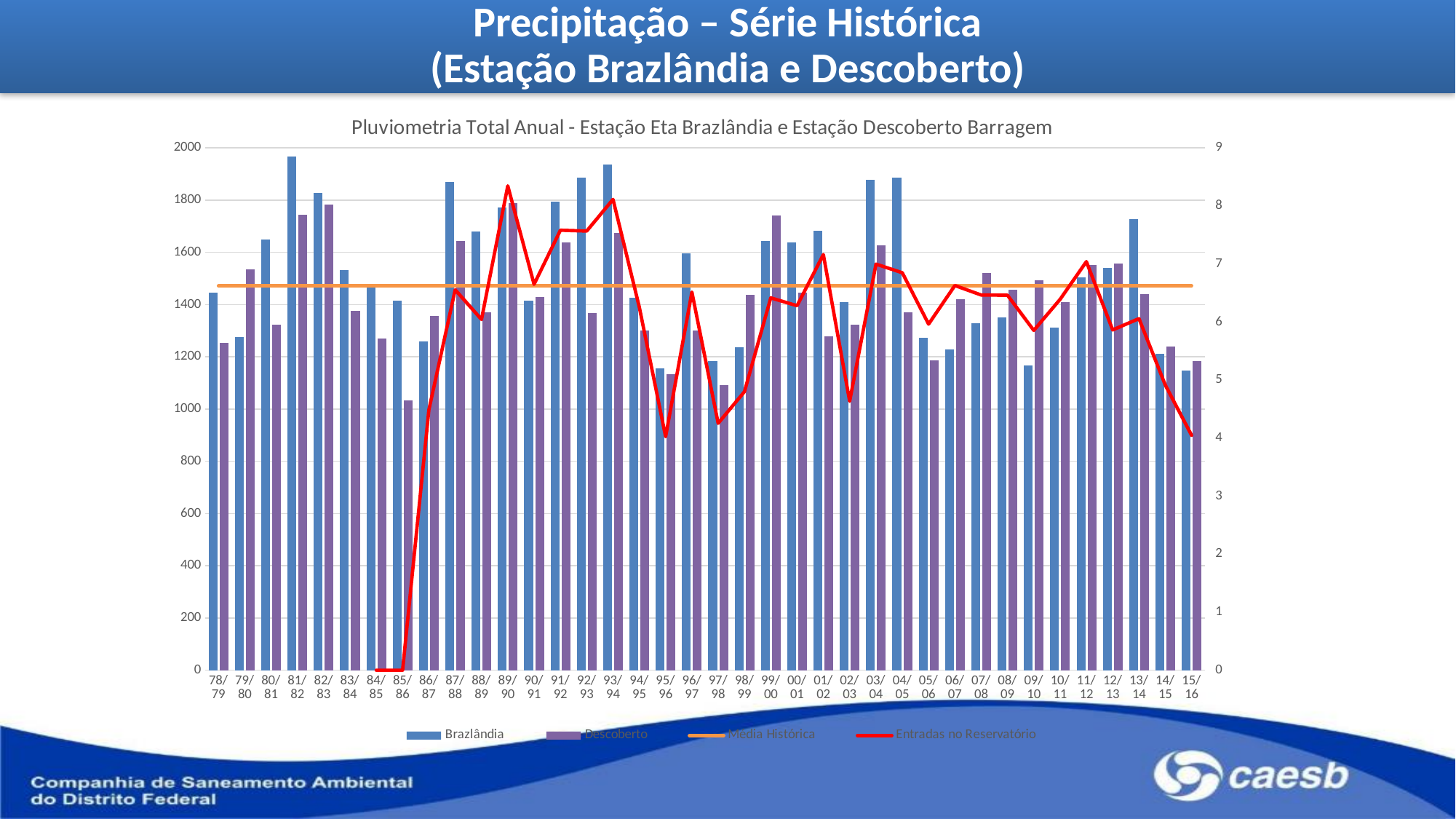
Is the Descoberto value for 85/86 greater or less than 1200? less How many series does the legend list? 4 Which year has the lowest Descoberto value? 85/86 Is the Entradas no Reservatório value for 15/16 greater or less than 5 on the right axis? less Does the Entradas no Reservatório line rise or fall from 11/12 to 15/16? fall Which year has the highest Brazlândia value? 81/82 How many year categories are shown on the x axis? 38 In 99/00, which is larger: the Brazlândia value or the Descoberto value? Descoberto Is the Brazlândia value for 81/82 greater or less than 1800? greater What is the title of the chart? Pluviometria Total Anual - Estação Eta Brazlândia e Estação Descoberto Barragem What kind of chart is shown on the slide? Bar chart with line series